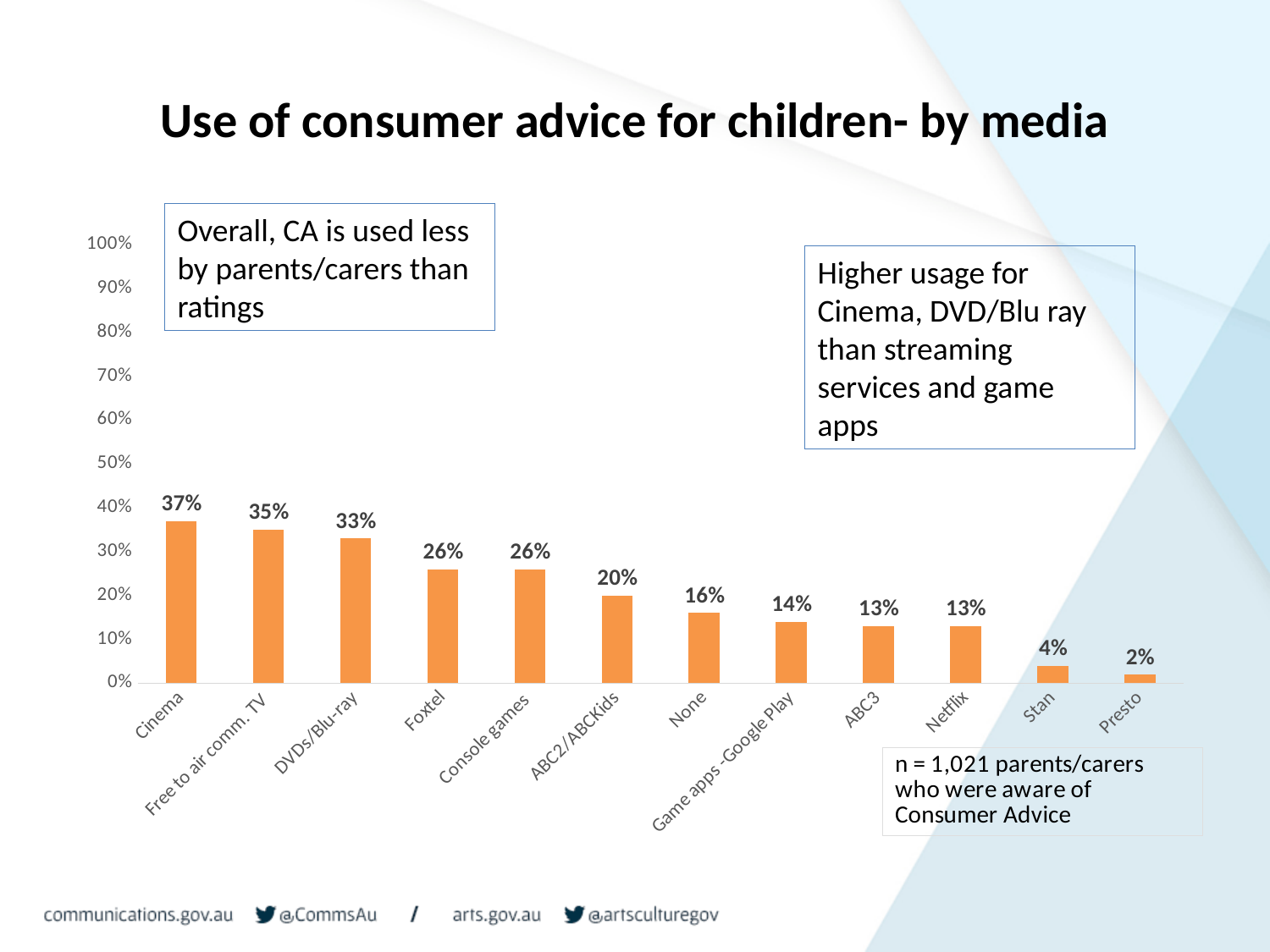
Which category has the highest value? Cinema What is the value for Cinema? 37% What kind of chart is shown on the slide? bar chart Which is larger, the value for Free to air comm. TV or the value for Netflix? Free to air comm. TV What is the difference between the values for Cinema and DVDs/Blu-ray? 4% What is the title of the chart? Use of consumer advice for children- by media What is the value for Foxtel? 26% How many categories are shown on the x axis? 12 Is the value for Stan greater or less than 10%? less What is the value for Game apps - Google Play? 14% Which category has the lowest value? Presto Do the values rise or fall from left to right along the x axis? fall